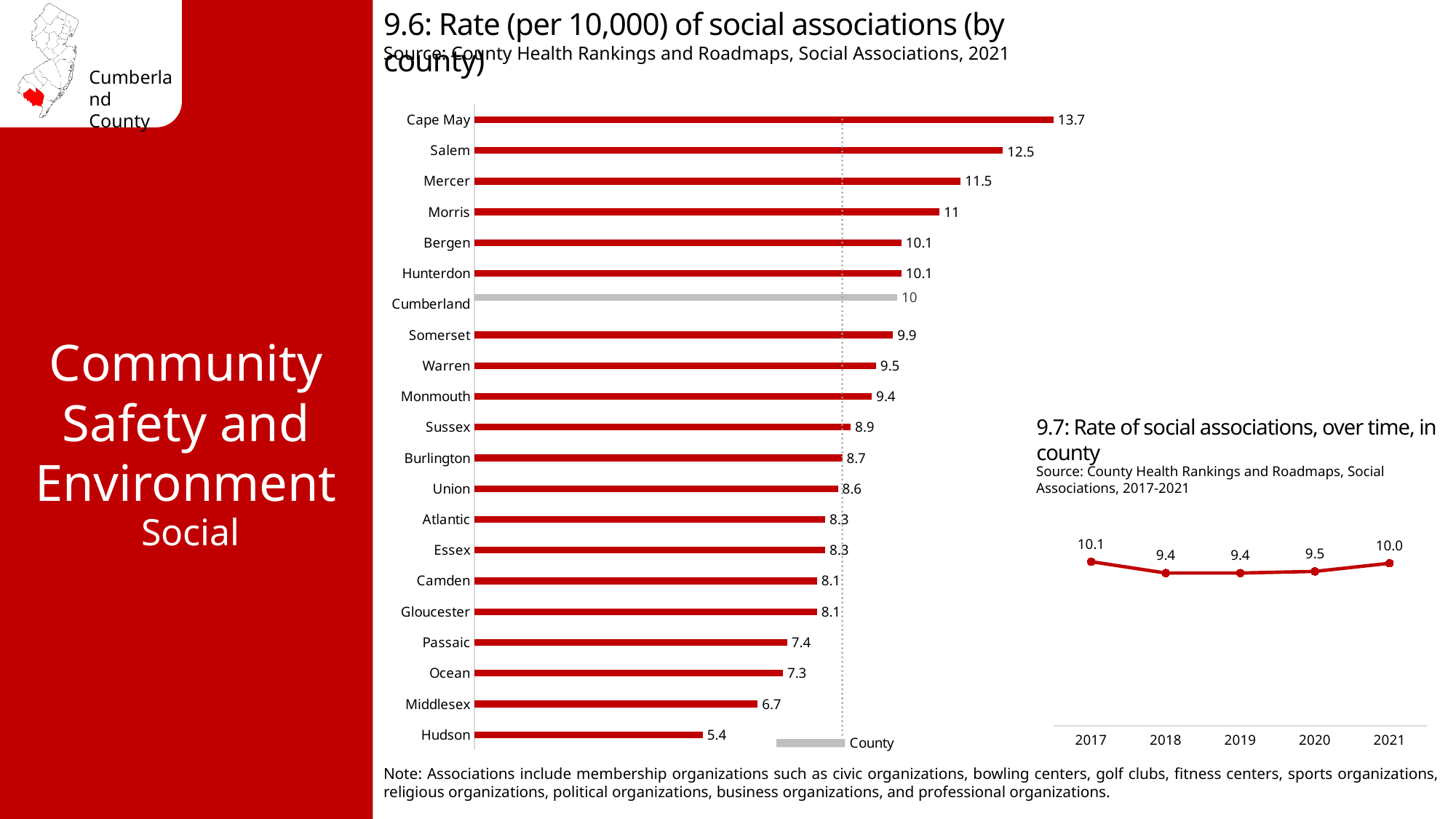
In the chart '9.7: Rate of social associations, over time, in county', what is the value for 2021? 10.0 What kind of chart is '9.6: Rate (per 10,000) of social associations (by county)'? Bar chart In the chart '9.6: Rate (per 10,000) of social associations (by county)', what is the difference between Cape May and Hudson? 8.3 What kind of chart is '9.7: Rate of social associations, over time, in county'? Line chart In the chart '9.7: Rate of social associations, over time, in county', what is the value for 2017? 10.1 In the chart '9.6: Rate (per 10,000) of social associations (by county)', what is the value for Salem? 12.5 In the chart '9.6: Rate (per 10,000) of social associations (by county)', how many counties are shown? 21 In the chart '9.6: Rate (per 10,000) of social associations (by county)', which is larger, Mercer or Morris? Mercer In the chart '9.6: Rate (per 10,000) of social associations (by county)', what is the value for Cumberland? 10 In the chart '9.7: Rate of social associations, over time, in county', how many years are plotted? 5 In the chart '9.6: Rate (per 10,000) of social associations (by county)', which county has the highest rate? Cape May In the chart '9.6: Rate (per 10,000) of social associations (by county)', which county has the lowest rate? Hudson